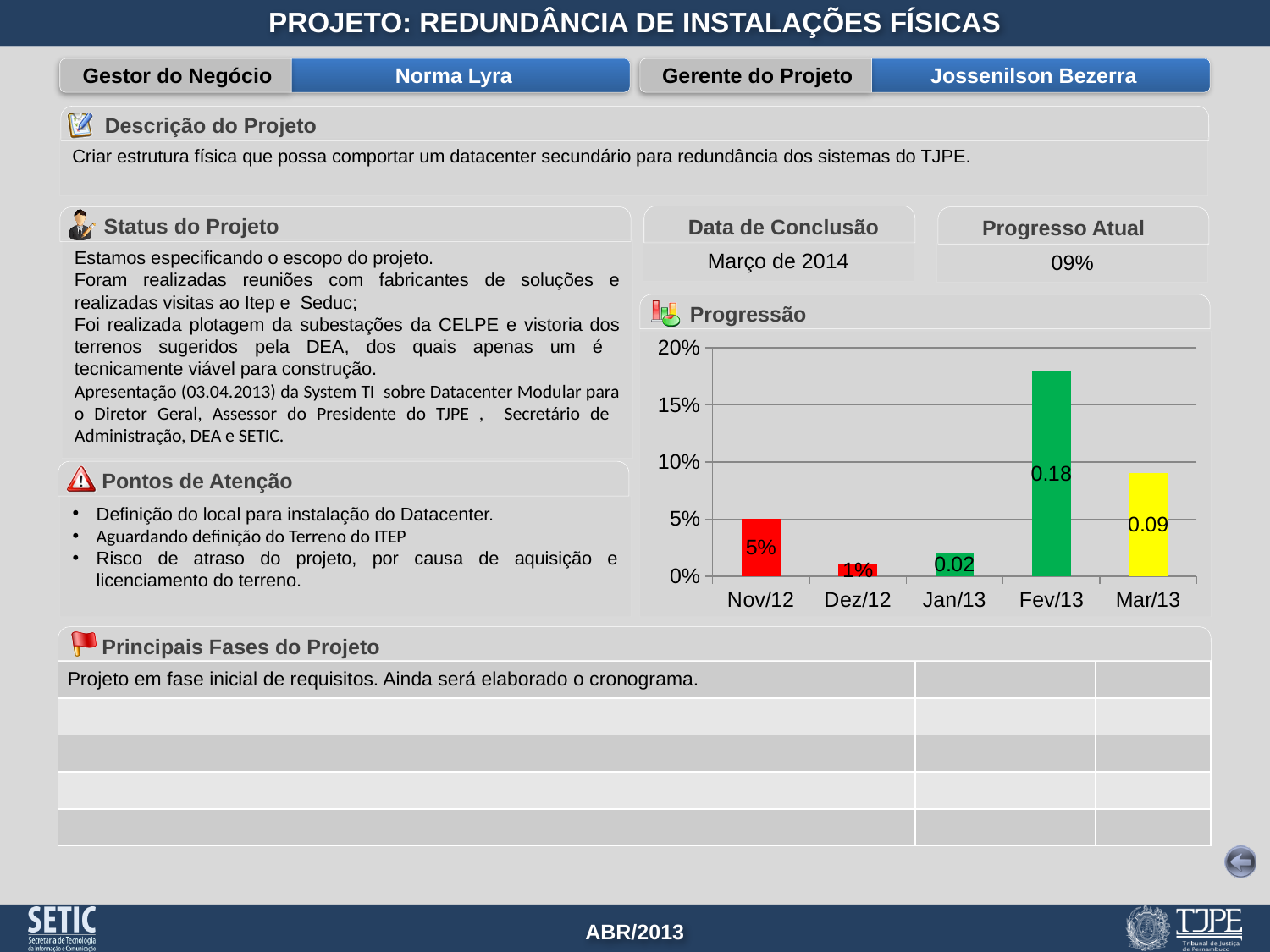
What is the data label on the Jan/13 bar in the Progressão chart? 0.02 What is the data label on the Dez/12 bar in the Progressão chart? 1% What is the data label on the Mar/13 bar in the Progressão chart? 0.09 What is the data label on the Fev/13 bar in the Progressão chart? 0.18 What kind of chart is shown under "Progressão"? bar chart In the Progressão chart, is the bar for Fev/13 greater or less than 15%? greater In the Progressão chart, which bar is taller, Fev/13 or Mar/13? Fev/13 How many months are shown on the x axis of the Progressão chart? 5 What is the data label on the Nov/12 bar in the Progressão chart? 5% Which month has the shortest bar in the Progressão chart? Dez/12 What is the title of the chart on the slide? Progressão Which month has the tallest bar in the Progressão chart? Fev/13